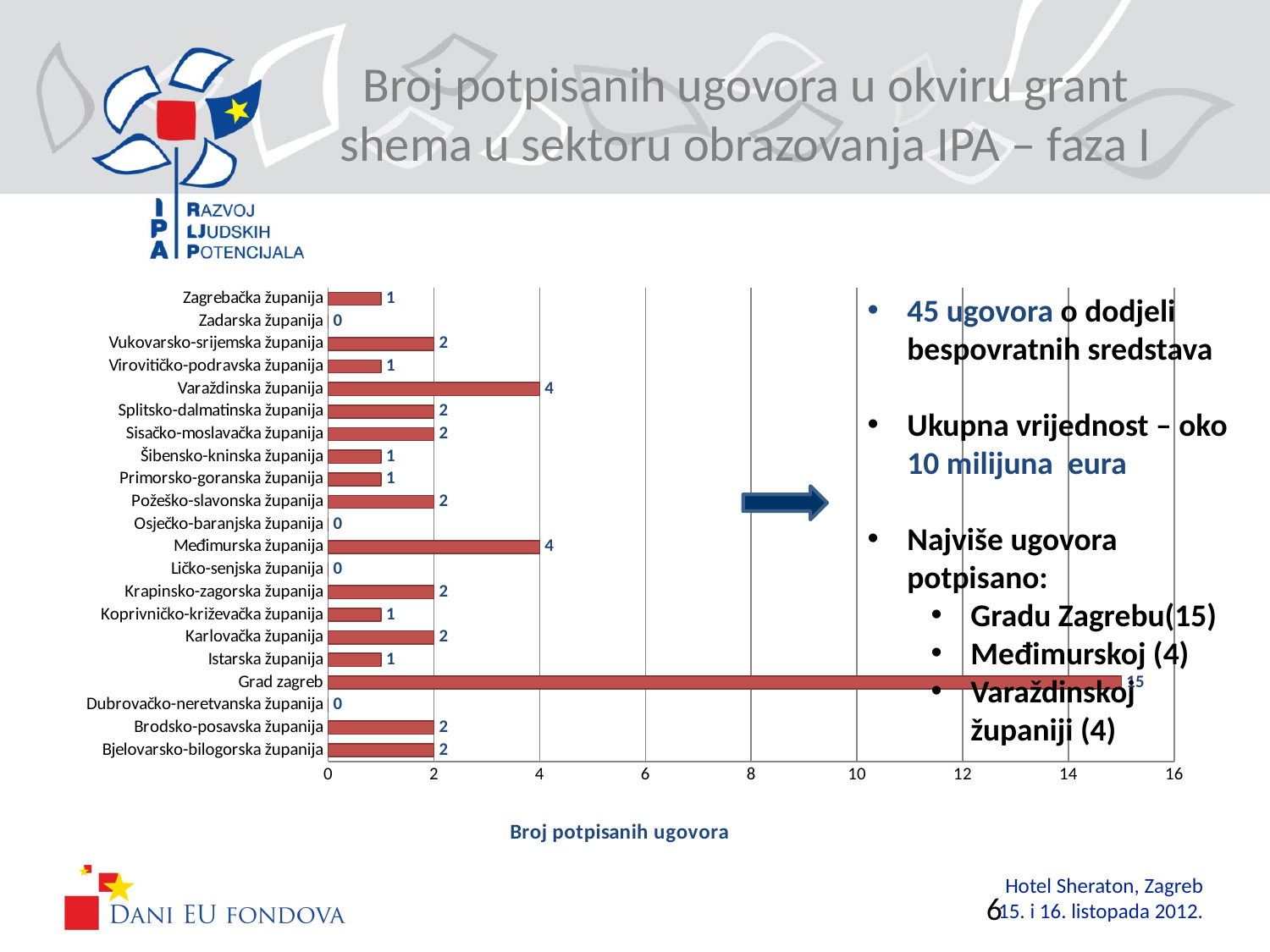
What is the value for Zadarska županija? 0 Which is larger, the value for Karlovačka županija or the value for Koprivničko-križevačka županija? Karlovačka županija How many categories are shown on the chart? 21 What is the difference between the values for Međimurska županija and Šibensko-kninska županija? 3 Is the value for Grad zagreb greater or less than 12? greater What type of chart is shown on the slide? bar chart What is the value for Istarska županija? 1 What is the value for Vukovarsko-srijemska županija? 2 What is the value for Varaždinska županija? 4 Which category has the highest value? Grad zagreb